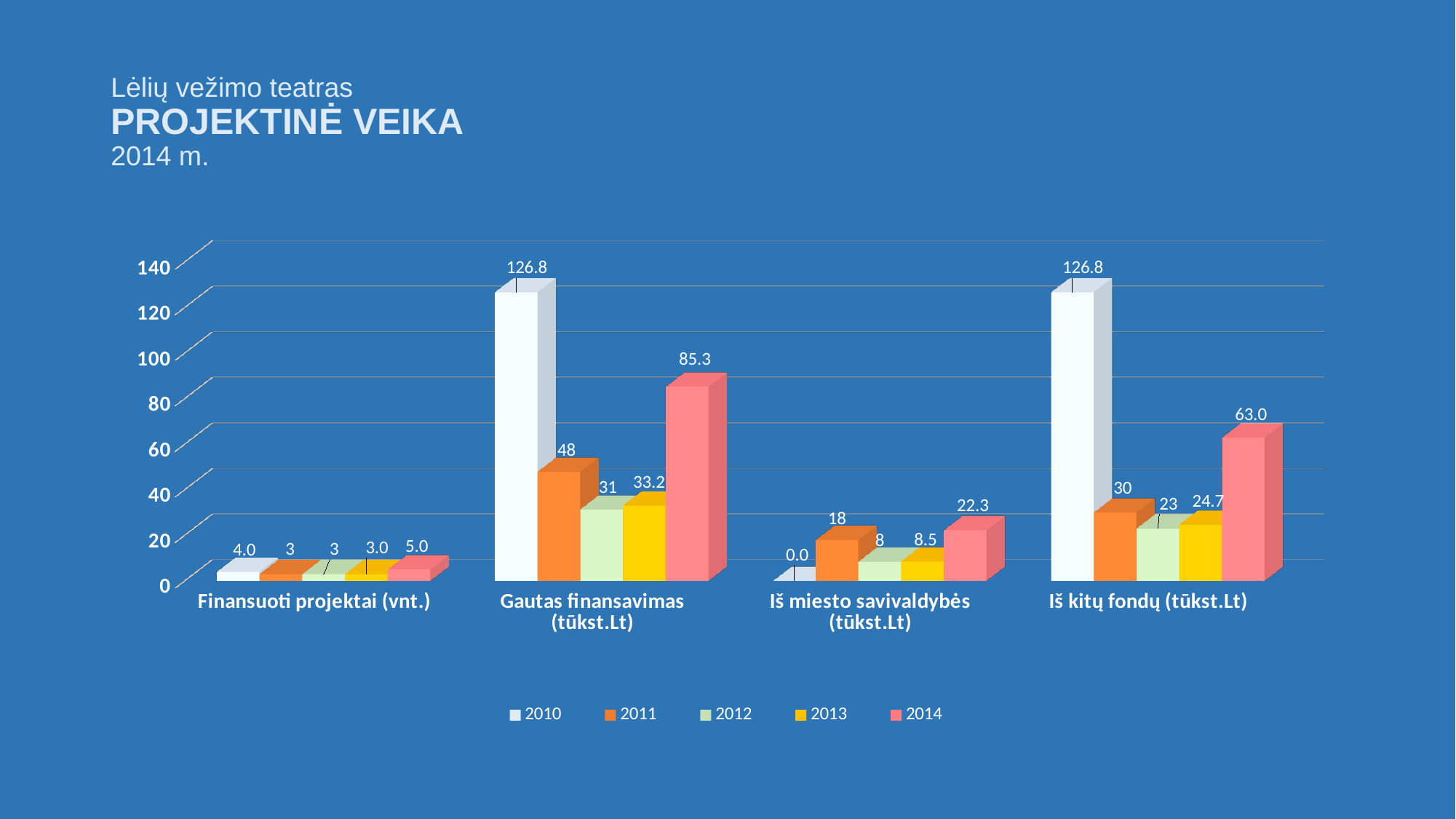
What is the value for 2014 in the Gautas finansavimas (tūkst.Lt) category? 85.3 Which year has the lowest value in the Iš miesto savivaldybės (tūkst.Lt) category? 2010 Which is larger in the Gautas finansavimas (tūkst.Lt) category: the 2012 value or the 2013 value? 2013 How many series does the legend list? 5 What is the difference between the 2014 and 2011 values in the Iš kitų fondų (tūkst.Lt) category? 33.0 How many categories are shown on the x axis? 4 What is the value for 2013 in the Iš kitų fondų (tūkst.Lt) category? 24.7 What is the value for 2010 in the Finansuoti projektai (vnt.) category? 4.0 What kind of chart is shown on the slide? bar chart Which year has the highest value in the Gautas finansavimas (tūkst.Lt) category? 2010 Is the 2014 value for Iš kitų fondų (tūkst.Lt) greater or less than 80? less What is the value for 2011 in the Iš miesto savivaldybės (tūkst.Lt) category? 18